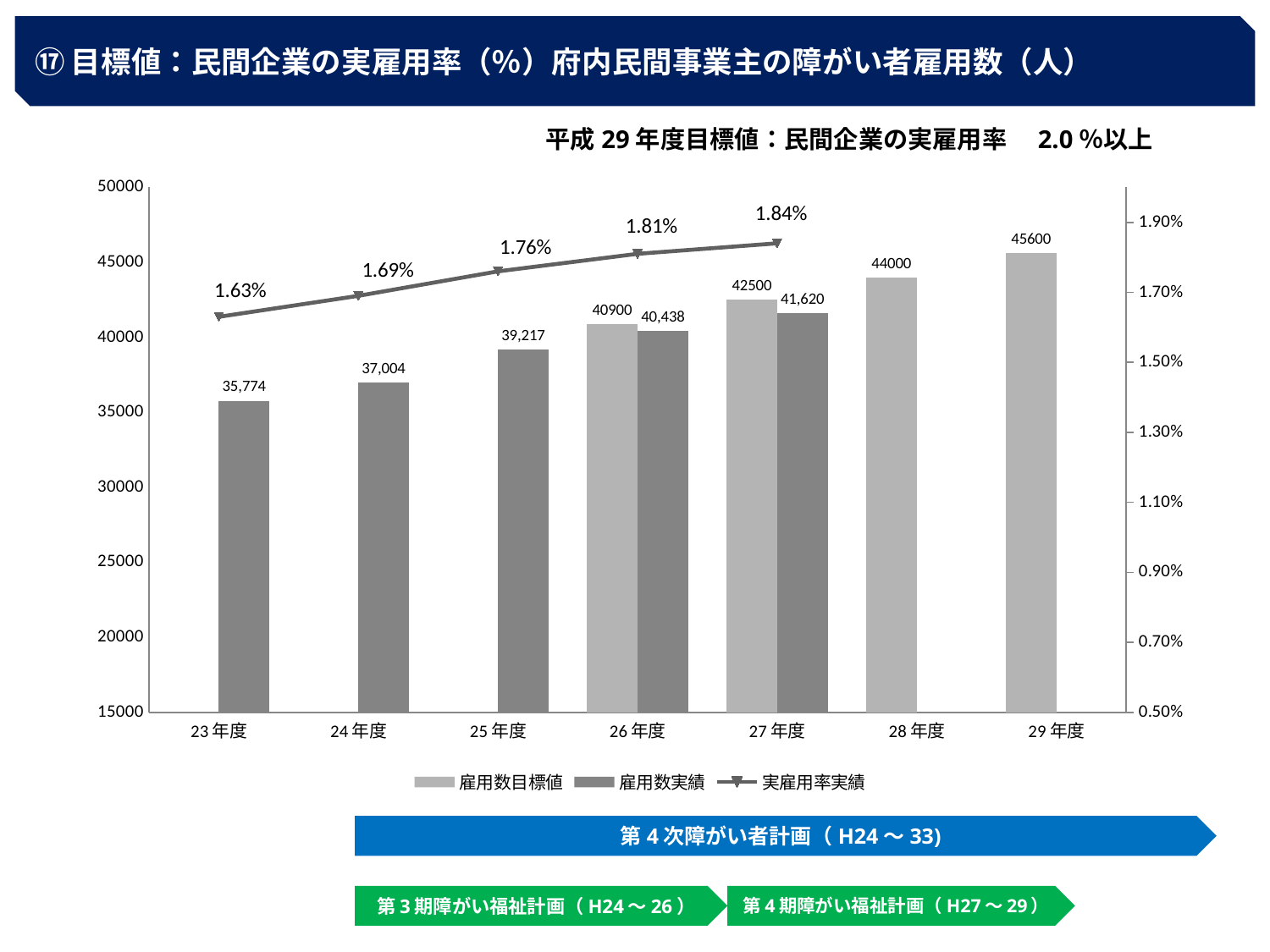
What is the 雇用数目標値 value for 29年度? 45600 Which year has the highest 実雇用率実績 value? 27年度 What is the 実雇用率実績 value for 25年度? 1.76% Is the 雇用数実績 value for 24年度 greater or less than 40000? less Does the 実雇用率実績 line rise or fall from 23年度 to 27年度? rise What kind of chart is shown on the slide? Combined bar and line chart What is the difference between the 雇用数目標値 and 雇用数実績 values for 27年度? 880 How many series does the legend list? 3 For 26年度, which is larger: 雇用数目標値 or 雇用数実績? 雇用数目標値 How many year categories are shown on the x axis? 7 Which year has the lowest 雇用数実績 value? 23年度 What is the 雇用数実績 value for 23年度? 35,774